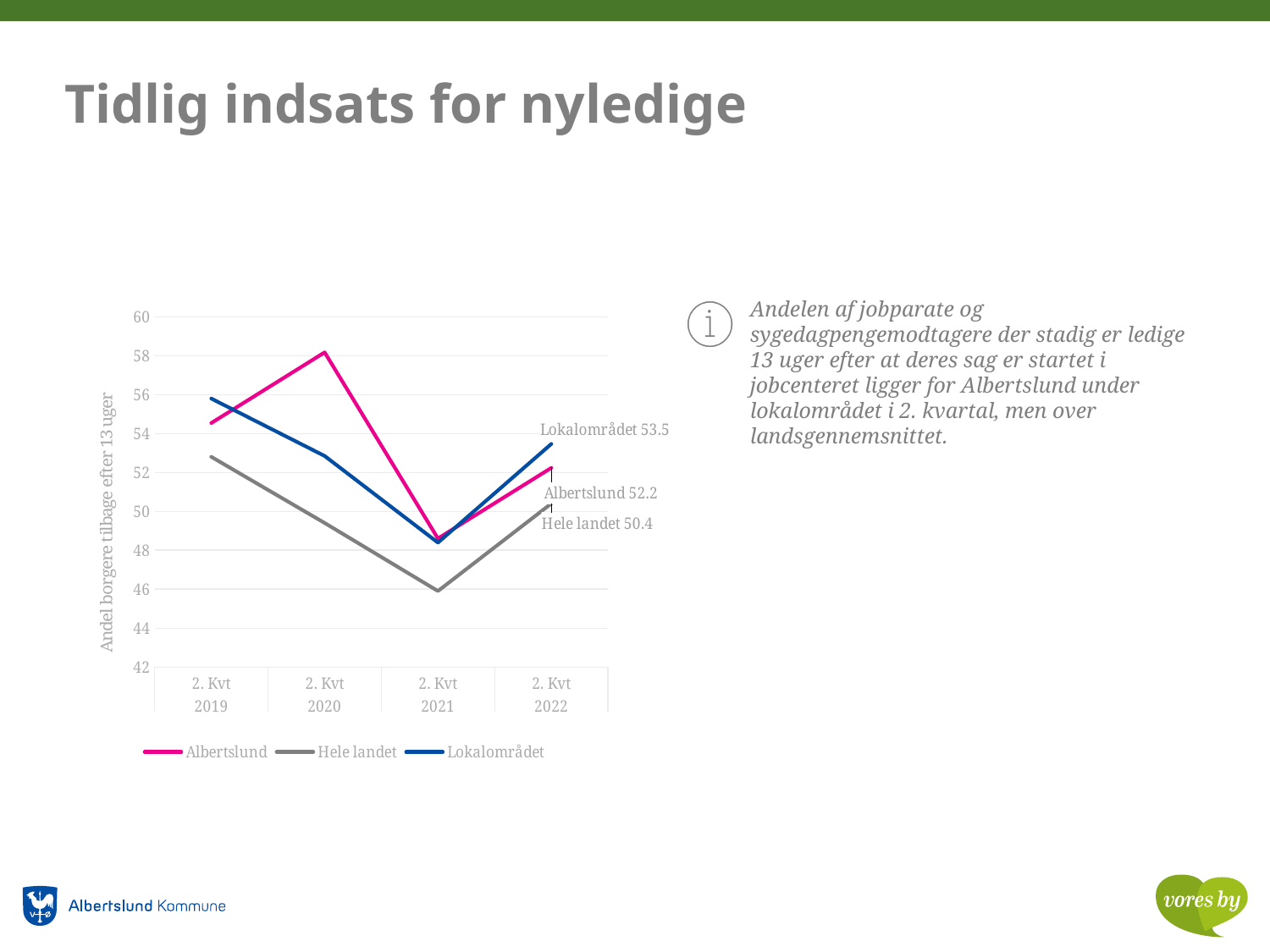
How many points are there along the x axis of the chart? 4 In 2. Kvt 2022, what is the difference between Albertslund and Hele landet? 1.8 Which series has the highest value in 2. Kvt 2022? Lokalområdet What is the value for Albertslund in 2. Kvt 2022? 52.2 How many series does the chart legend list? 3 Does the Hele landet line rise or fall from 2. Kvt 2019 to 2. Kvt 2021? Fall Is the value for Hele landet in 2. Kvt 2021 greater or less than 48? less In 2. Kvt 2022, how much higher is Lokalområdet than Albertslund? 1.3 What kind of chart is shown on the slide? Line chart What is the value for Hele landet in 2. Kvt 2022? 50.4 Is the value for Albertslund in 2. Kvt 2020 greater or less than 56? greater What is the value for Lokalområdet in 2. Kvt 2022? 53.5